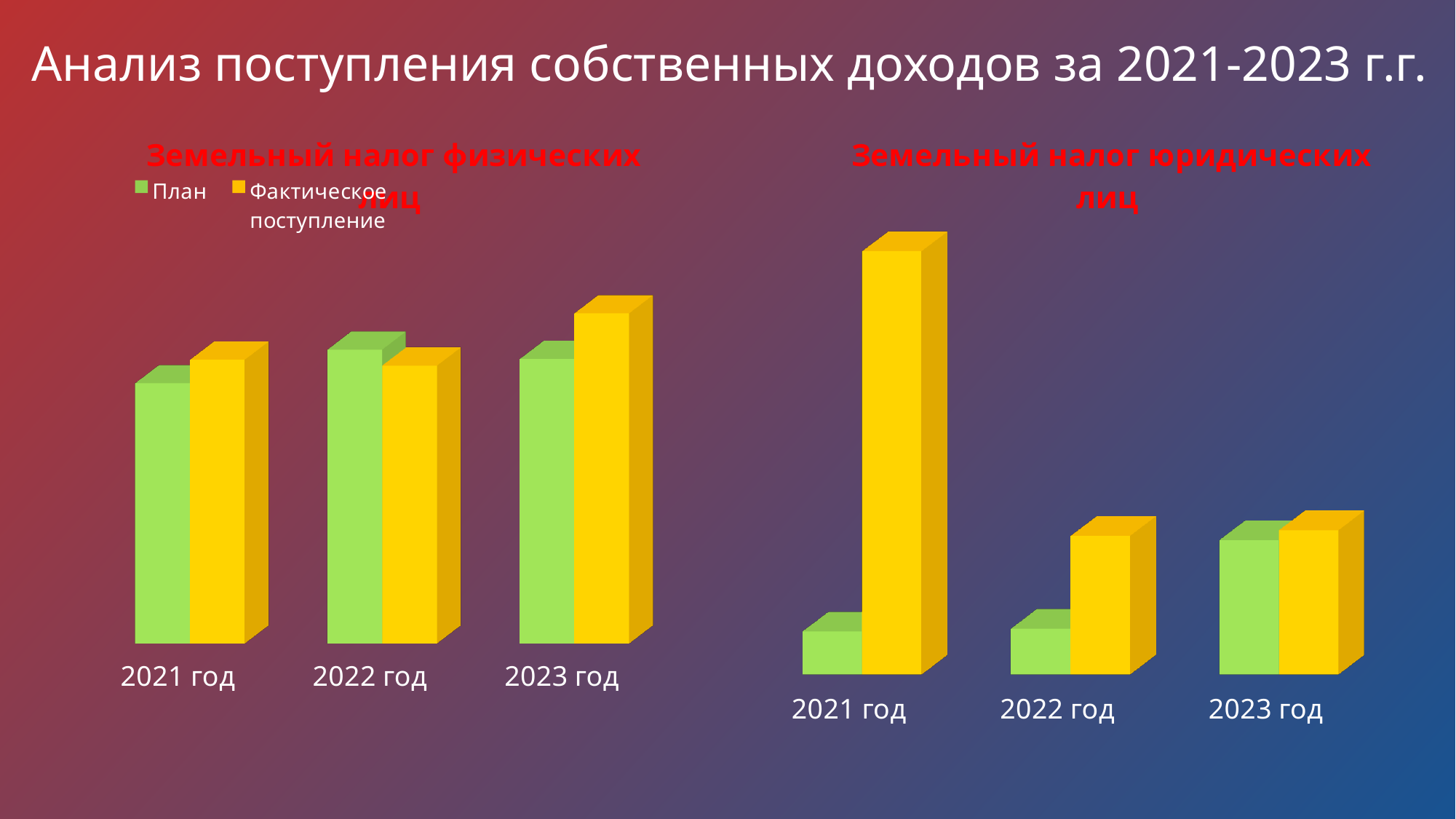
In the left chart "Земельный налог физических лиц", which series is shown in green? План What kind of chart is the left chart titled "Земельный налог физических лиц"? Bar chart In the right chart "Земельный налог юридических лиц", how many categories are shown? 3 In the left chart "Земельный налог физических лиц", which year has the highest Фактическое поступление? 2023 год What kind of chart is the right chart titled "Земельный налог юридических лиц"? Bar chart In the left chart "Земельный налог физических лиц", how many years are shown on the x axis? 3 How many series does the legend of the left chart "Земельный налог физических лиц" list? 2 In the left chart "Земельный налог физических лиц", which series is shown in yellow? Фактическое поступление In the left chart "Земельный налог физических лиц", which year has the lowest План? 2021 год In the right chart "Земельный налог юридических лиц", which year has the highest Фактическое поступление? 2021 год In the right chart "Земельный налог юридических лиц", does Фактическое поступление rise or fall from 2021 год to 2023 год? Fall In the right chart "Земельный налог юридических лиц", for 2021 год, which is larger: План or Фактическое поступление? Фактическое поступление